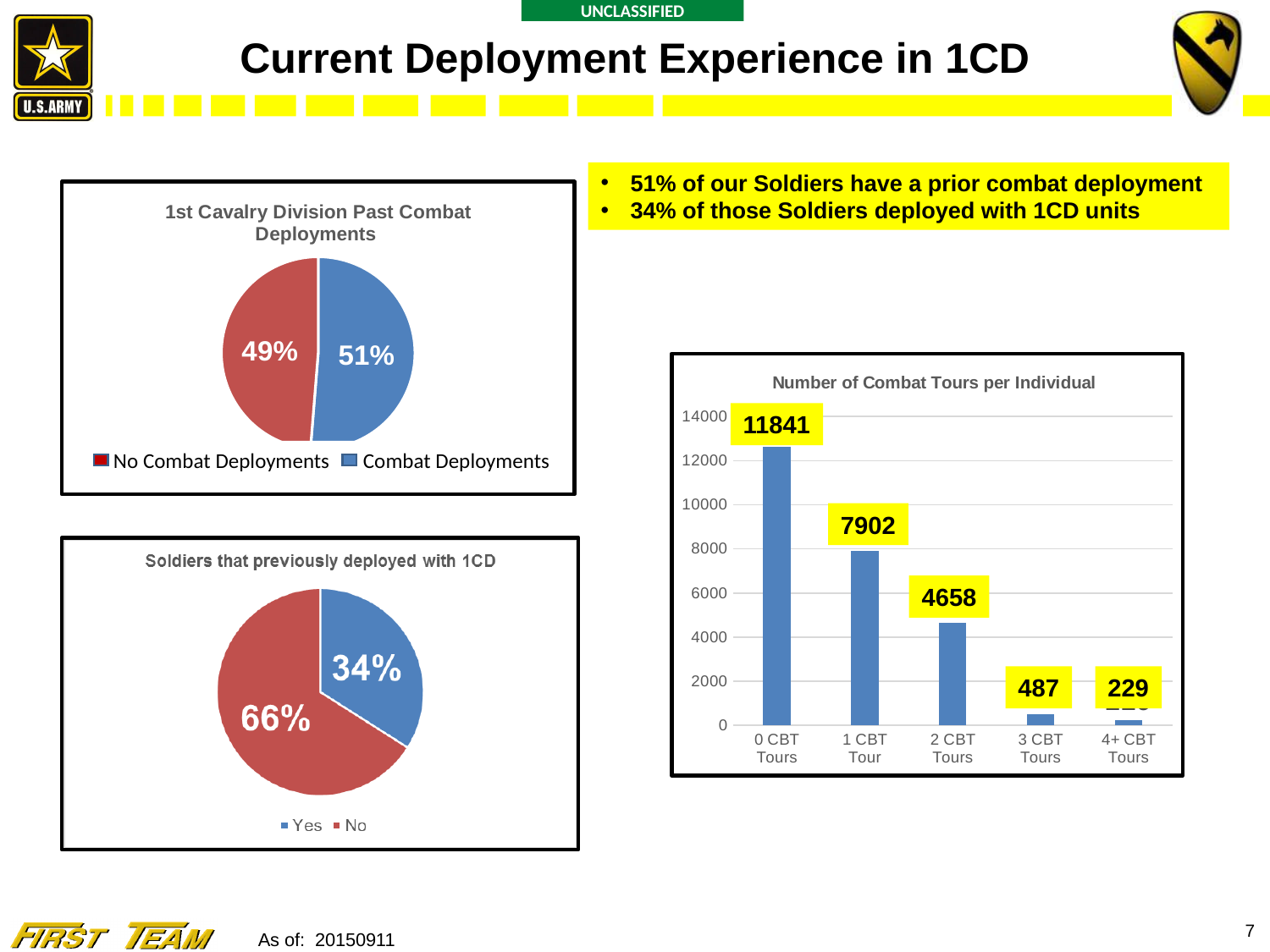
In the 'Number of Combat Tours per Individual' chart, what is the value for 0 CBT Tours? 11841 In the 'Number of Combat Tours per Individual' chart, how many categories are shown on the x axis? 5 In the 'Number of Combat Tours per Individual' chart, which category has the lowest value? 4+ CBT Tours In the 'Number of Combat Tours per Individual' chart, do the values rise or fall from left to right along the x axis? fall In the '1st Cavalry Division Past Combat Deployments' pie chart, which slice is larger, No Combat Deployments or Combat Deployments? Combat Deployments In the 'Soldiers that previously deployed with 1CD' pie chart, what colour is the Yes slice? blue In the 'Number of Combat Tours per Individual' chart, which category has the highest value? 0 CBT Tours In the 'Soldiers that previously deployed with 1CD' pie chart, what share is No? 66% In the '1st Cavalry Division Past Combat Deployments' pie chart, what share is Combat Deployments? 51% What kind of chart is 'Number of Combat Tours per Individual'? bar chart In the 'Number of Combat Tours per Individual' chart, what is the difference between the values for 1 CBT Tour and 2 CBT Tours? 3244 In the 'Number of Combat Tours per Individual' chart, what is the value for 2 CBT Tours? 4658